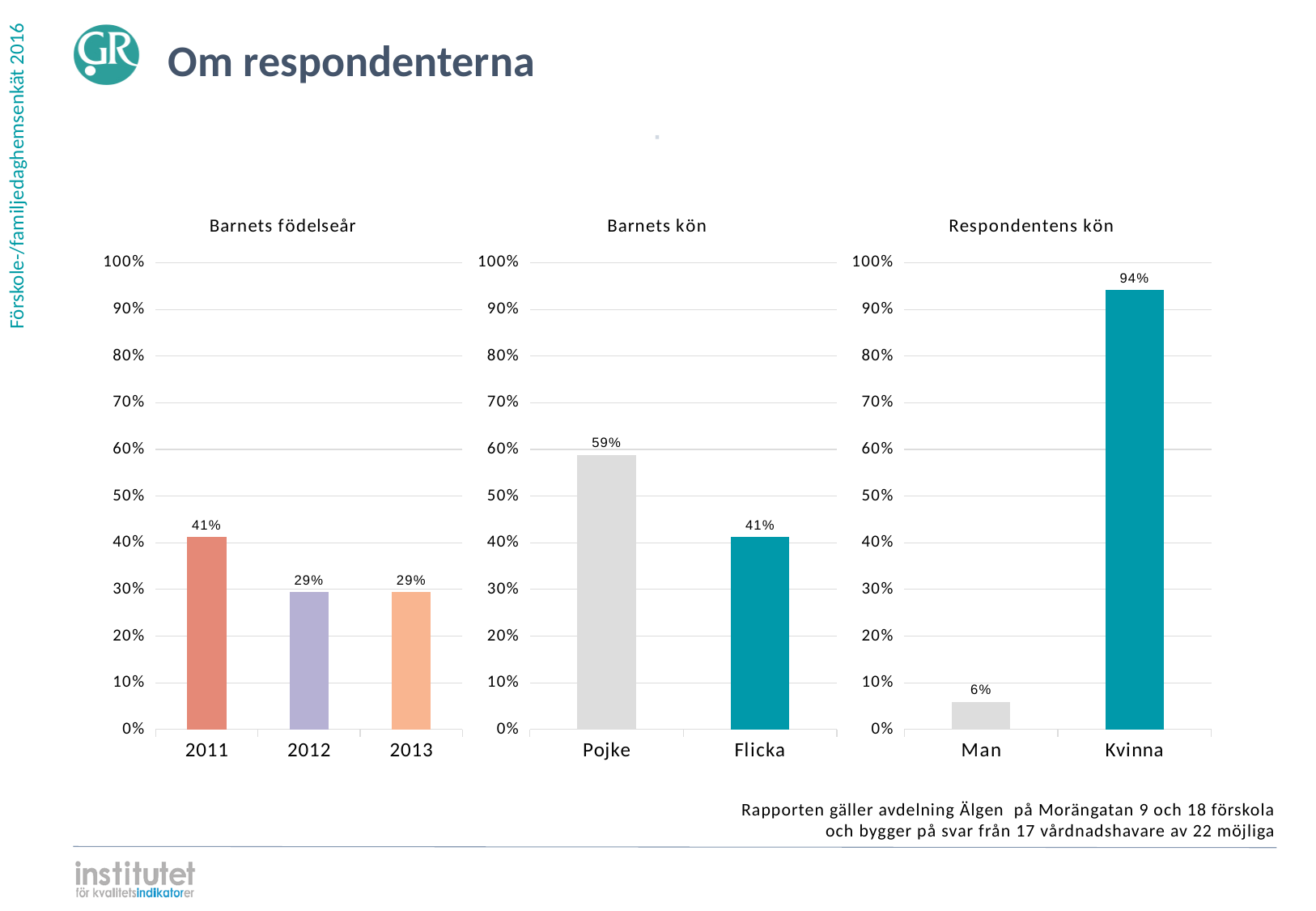
In the 'Barnets födelseår' chart, what is the value for 2011? 41% In the 'Respondentens kön' chart, what is the value for Man? 6% In the 'Barnets födelseår' chart, which birth year has the highest value? 2011 In the 'Barnets födelseår' chart, how many categories are shown on the x axis? 3 In the 'Barnets födelseår' chart, what is the difference between the values for 2011 and 2012? 12% In the 'Respondentens kön' chart, is the value for Kvinna greater or less than 90%? greater What kind of chart is the 'Respondentens kön' chart? Bar chart In the 'Barnets kön' chart, what is the difference between Pojke and Flicka? 18% In the 'Barnets kön' chart, which category is lower, Pojke or Flicka? Flicka In the 'Barnets kön' chart, what is the value for Pojke? 59% What is the title of the middle chart on the slide? Barnets kön In the 'Respondentens kön' chart, what is the value for Kvinna? 94%